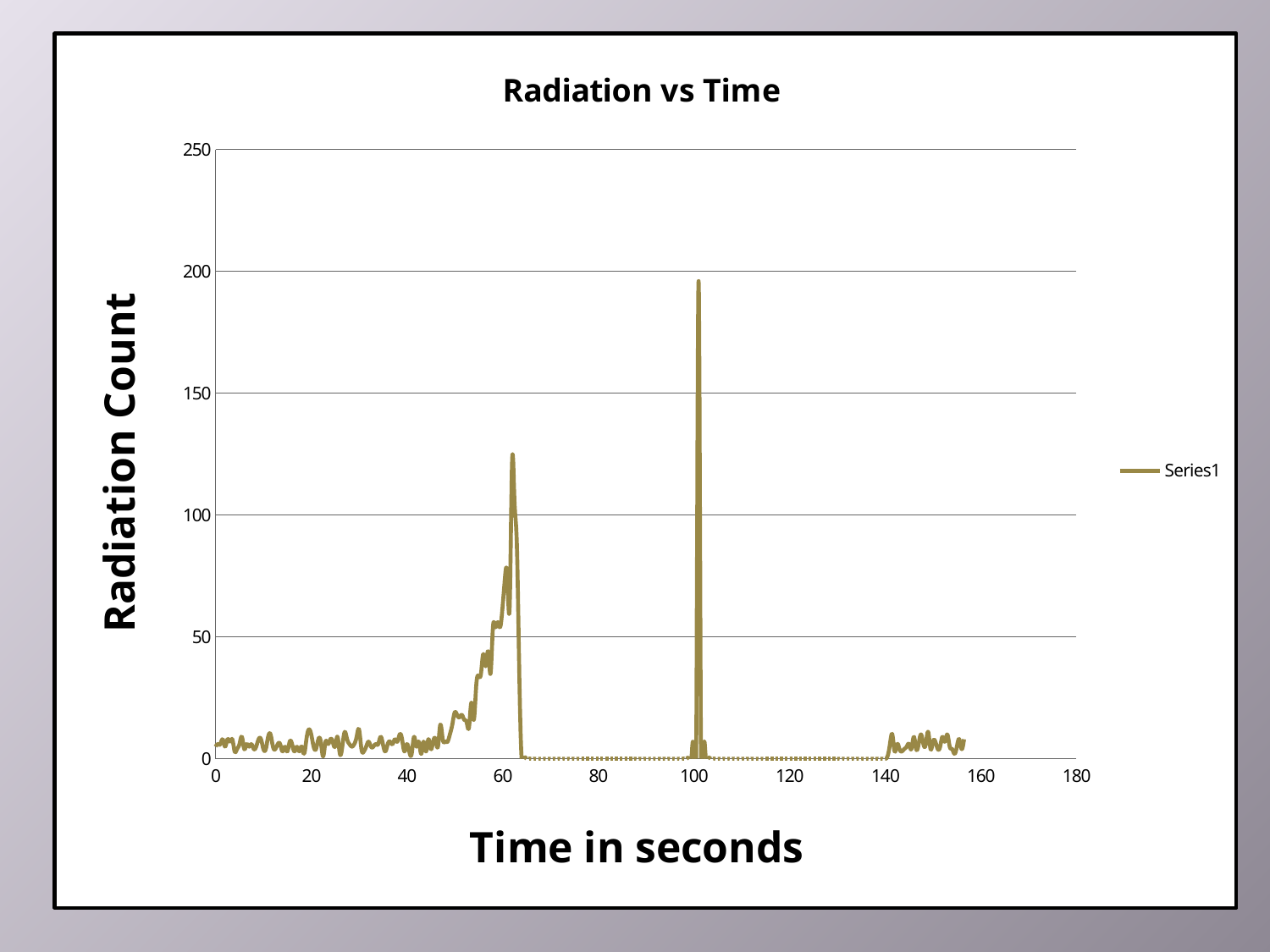
What kind of chart is shown on the slide? line chart Is the value of the line at 150 seconds greater or less than 50? less What is the label of the y axis? Radiation Count Do the values rise or fall between 40 and 60 seconds? rise Is the value of the line at 80 seconds greater or less than 50? less Is the highest peak of the line, near 100 seconds, greater or less than 150? greater Which is larger: the peak near 60 seconds or the peak near 100 seconds? the peak near 100 seconds How many series does the legend list? 1 What is the title of the chart? Radiation vs Time